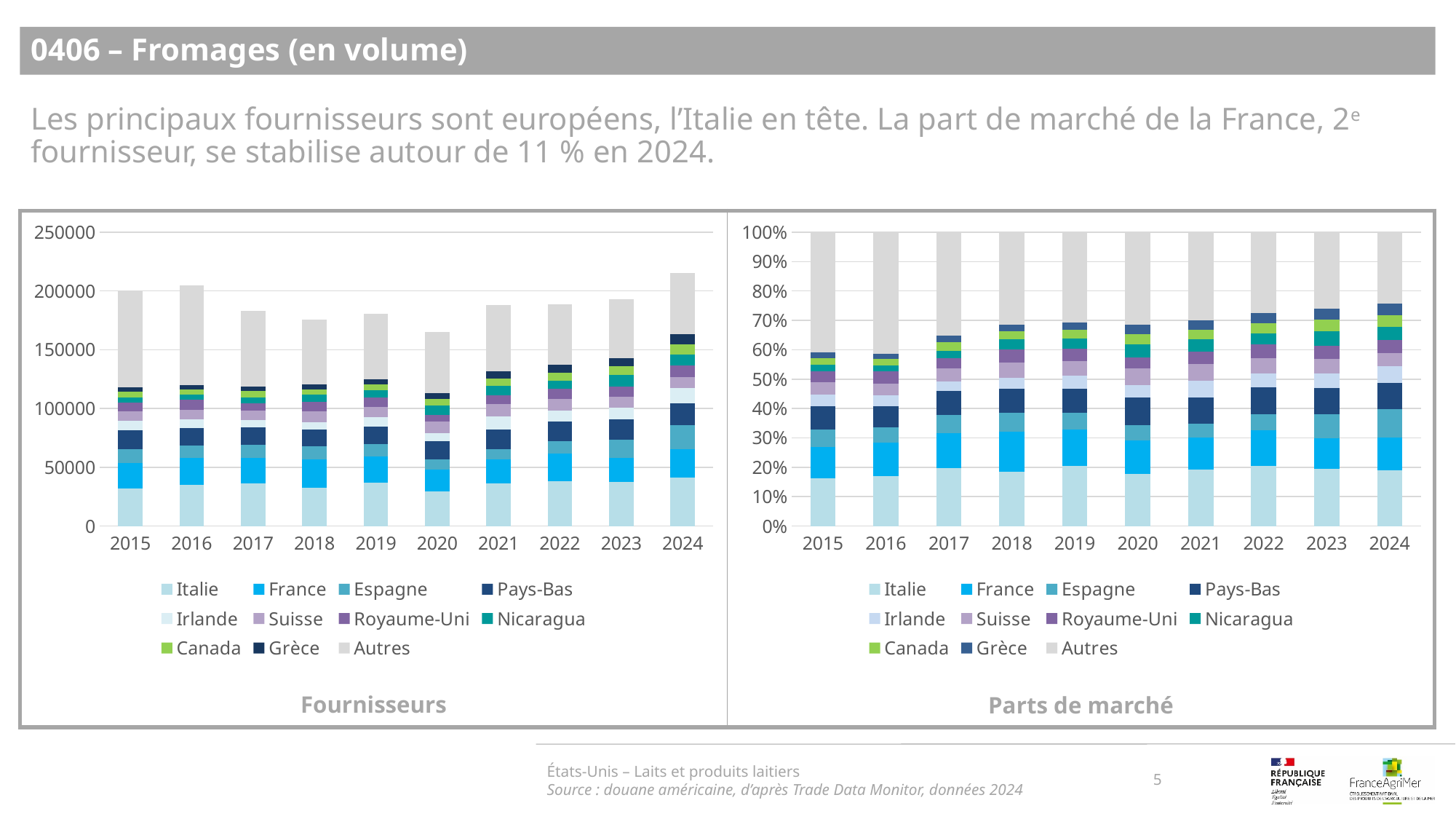
How many series does the legend of the 'Fournisseurs' chart list? 11 What is the title of the chart on the right side of the slide? Parts de marché In the 'Parts de marché' chart, is the Italie share for 2015 greater or less than 20%? less In the 'Fournisseurs' chart, is the total bar for 2020 greater or less than 200000? less What kind of chart is the 'Fournisseurs' chart on the left? stacked bar chart In the 'Fournisseurs' chart, which total bar is larger, 2015 or 2024? 2024 In the 'Parts de marché' chart, is the Autres share for 2024 greater or less than 30%? less In the 'Fournisseurs' chart, which year has the highest total bar? 2024 In the 'Fournisseurs' chart, do the total bars rise or fall from 2020 to 2024? rise In the 'Fournisseurs' chart, which year has the lowest total bar? 2020 How many years are shown on the x axis of the 'Parts de marché' chart? 10